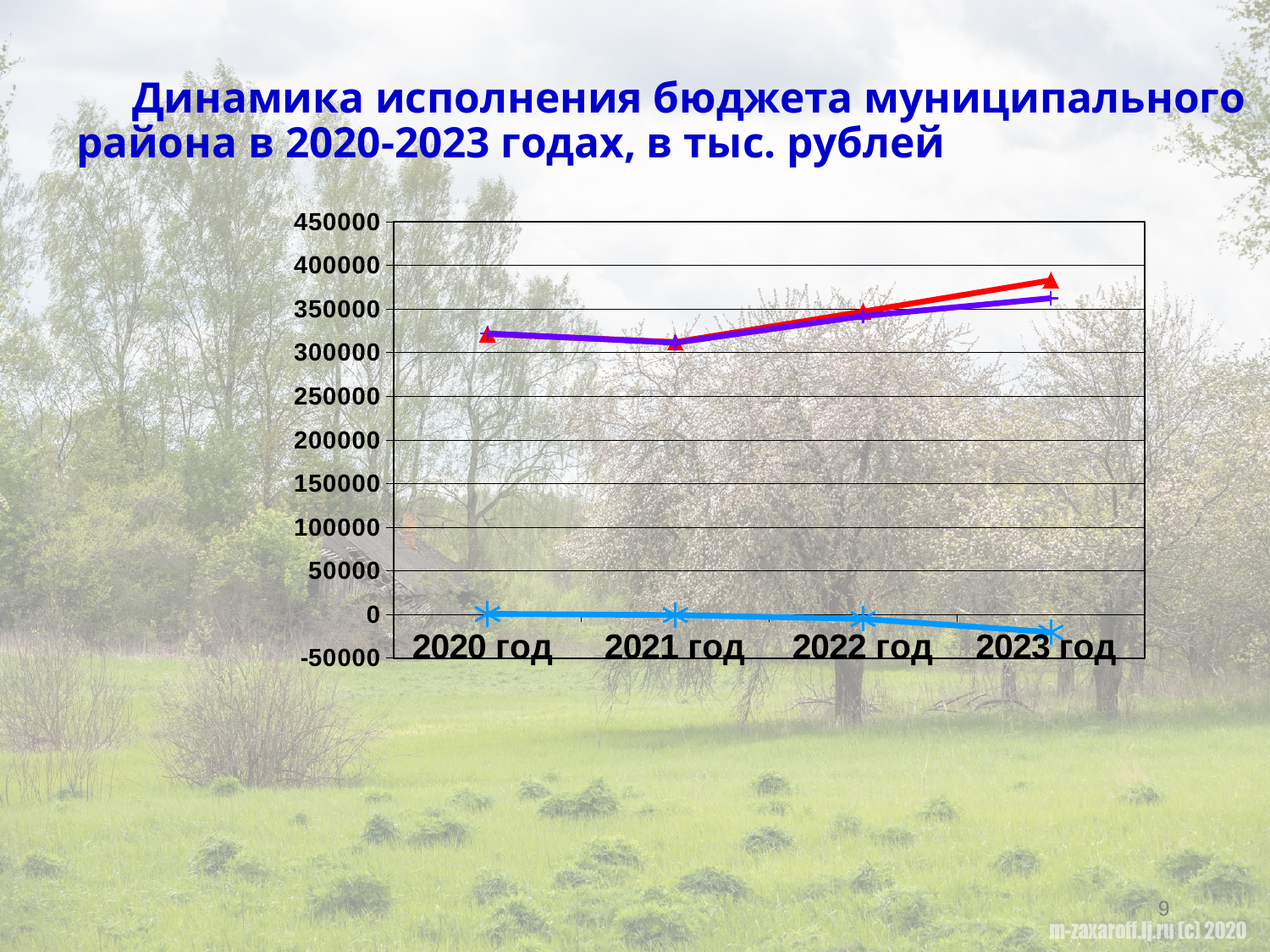
What kind of chart is shown on the slide? line chart Is the value of the red line for 2020 год greater or less than 300000? greater How many lines are plotted on the chart? 3 In 2022 год, which line has the higher value, the red line or the blue line? the red line Is the value of the blue line for 2020 год greater or less than 50000? less Is the value of the red line for 2021 год greater or less than 350000? less How many years are shown on the x axis of the chart? 4 In 2023 год, which line has the higher value, the red line or the purple line? the red line In which year does the red line reach its highest value? 2023 год Does the blue line rise or fall from 2020 год to 2023 год? fall